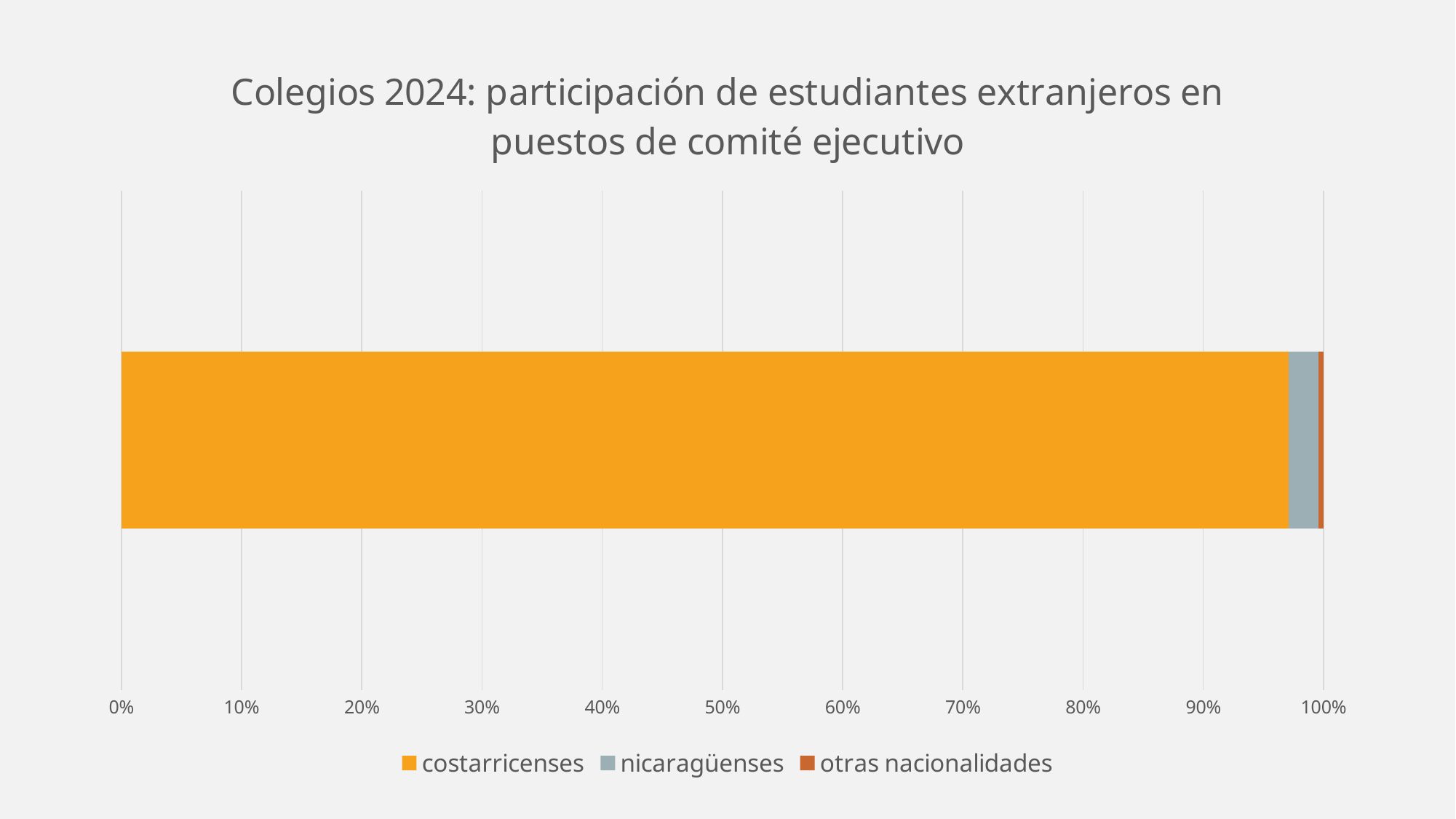
Is the value for costarricenses greater or less than 90%? greater Which series takes up the largest share of the bar? costarricenses Is the value for nicaragüenses greater or less than 10%? less Is the value for otras nacionalidades greater or less than 10%? less How many bars are plotted in the chart? 1 Which is larger, the share for nicaragüenses or the share for otras nacionalidades? nicaragüenses What is the title of the chart? Colegios 2024: participación de estudiantes extranjeros en puestos de comité ejecutivo Which series is shown in the gray-blue colour? nicaragüenses How many series does the legend list? 3 What kind of chart is shown on the slide? bar chart Which is larger, the share for costarricenses or the share for nicaragüenses? costarricenses Which series takes up the smallest share of the bar? otras nacionalidades